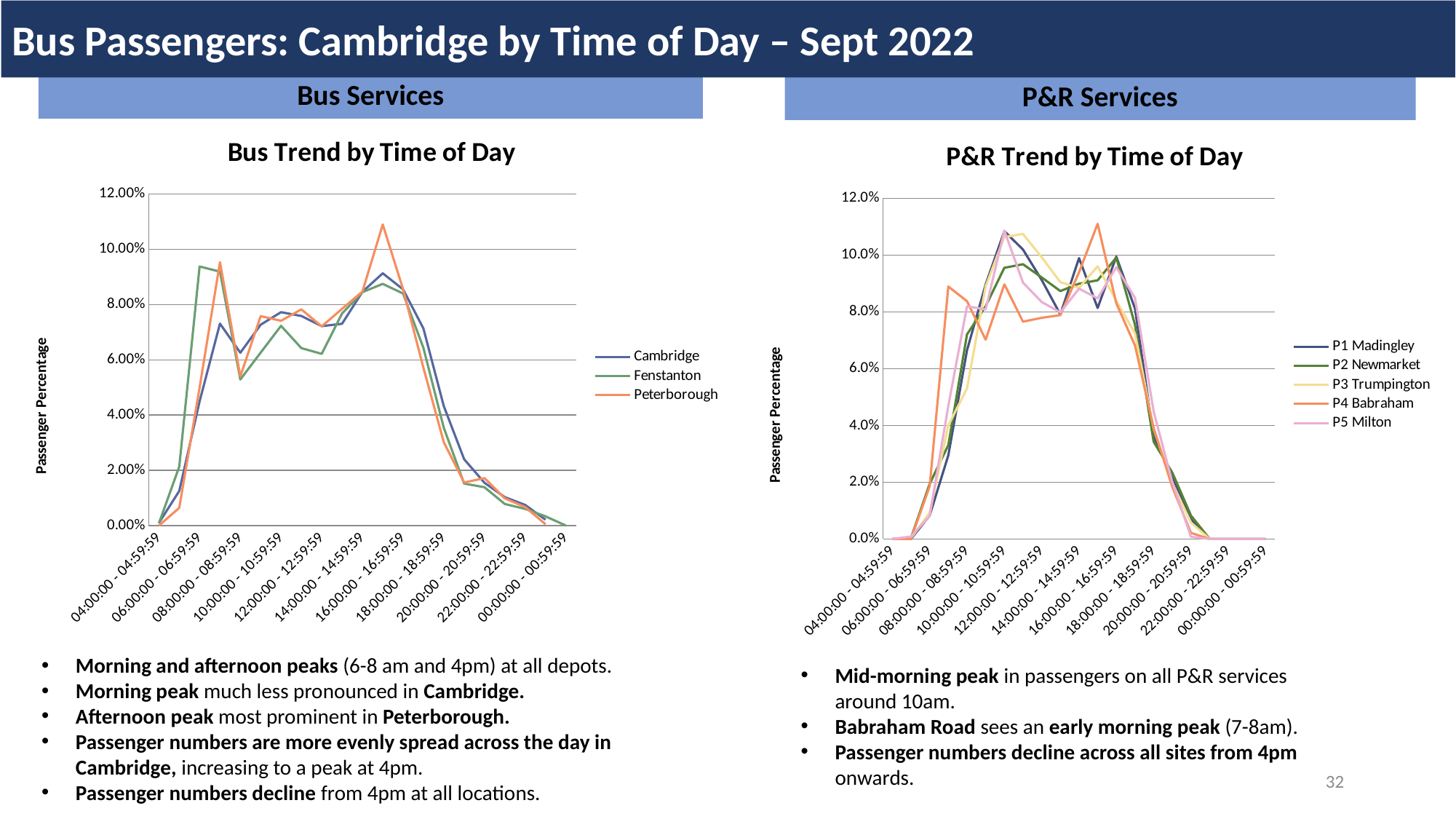
What kind of chart is the 'Bus Trend by Time of Day' chart? line chart How many series does the legend of the 'P&R Trend by Time of Day' chart list? 5 Which series in the 'P&R Trend by Time of Day' chart is drawn in orange? P4 Babraham In the 'P&R Trend by Time of Day' chart, is the value for P4 Babraham at 16:00:00 - 16:59:59 greater or less than 10.0%? less In the 'Bus Trend by Time of Day' chart, which is higher at 06:00:00 - 06:59:59, Fenstanton or Cambridge? Fenstanton What is the y-axis label of the 'P&R Trend by Time of Day' chart? Passenger Percentage In the 'Bus Trend by Time of Day' chart, is the value for Cambridge at 06:00:00 - 06:59:59 greater or less than 8.00%? less In the 'P&R Trend by Time of Day' chart, do the values rise or fall from 16:00:00 - 16:59:59 to 22:00:00 - 22:59:59? fall In the 'Bus Trend by Time of Day' chart, is the value for Peterborough at 16:00:00 - 16:59:59 greater or less than 10.00%? less How many series does the legend of the 'Bus Trend by Time of Day' chart list? 3